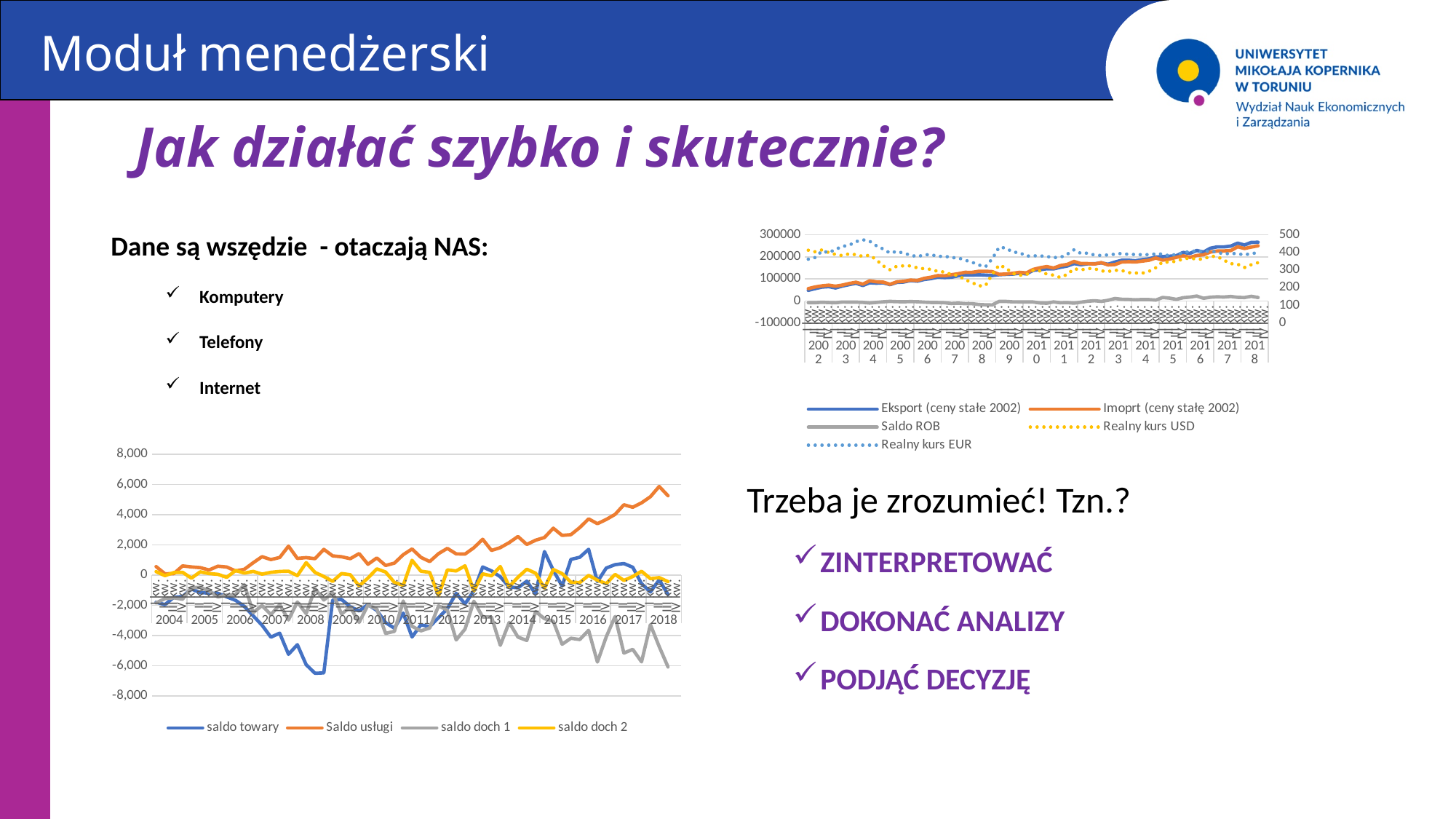
In the bottom-left chart, is the lowest value of the saldo towary series greater or less than -6,000? less What kind of chart is the chart at the bottom left of the slide? line chart In the top-right chart, does the Eksport (ceny stałe 2002) series rise or fall from 2002 to 2018? rise How many series does the legend of the bottom-left chart list? 4 In the bottom-left chart, is the highest value of the Saldo usługi series greater or less than 4,000? greater In the bottom-left chart, which series reaches the highest value at the end of the period (2018)? Saldo usługi How many series does the legend of the top-right chart list? 5 What kind of chart is the chart at the top right of the slide? line chart In the bottom-left chart, does the Saldo usługi series rise or fall over the years from 2004 to 2018? rise In the top-right chart, which series is drawn as a grey solid line? Saldo ROB In the top-right chart, is the Eksport (ceny stałe 2002) value in 2018 greater or less than 200000? greater In the bottom-left chart, which series is drawn in yellow? saldo doch 2